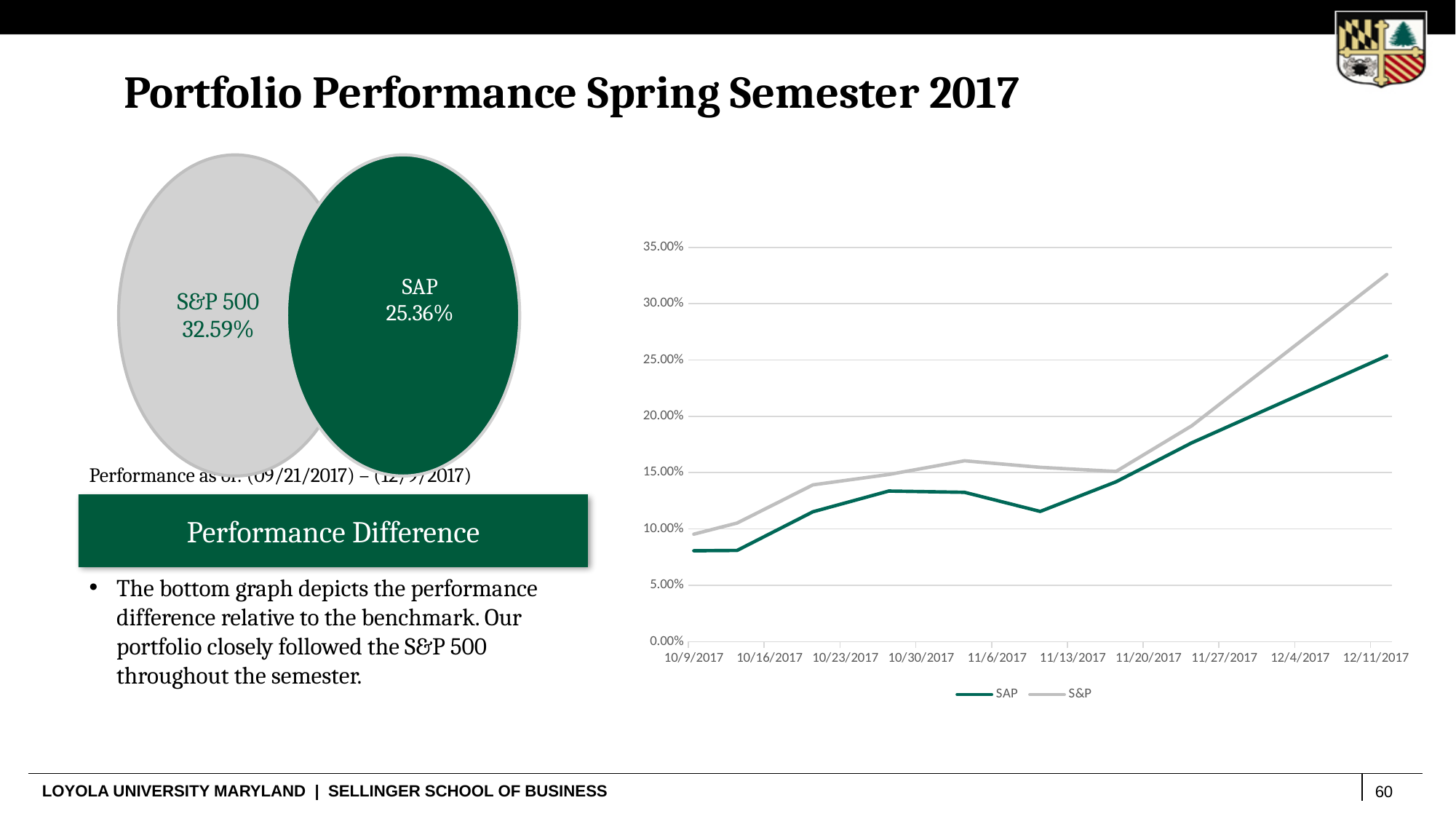
In the line chart, do the SAP and S&P values generally rise or fall from 10/9/2017 to 12/11/2017? rise In the line chart, is the S&P value on 12/11/2017 greater or less than 30.00%? greater In the line chart, is the SAP value on 11/13/2017 greater or less than 15.00%? less In the line chart, on which date does the S&P series reach its highest value? 12/11/2017 What are the two entries in the legend of the line chart? SAP and S&P In the line chart, is the SAP value on 12/11/2017 greater or less than 30.00%? less How many dates are shown along the x axis of the line chart? 10 How many series does the legend of the line chart list? 2 In the line chart, which series has the higher value on 12/11/2017, SAP or S&P? S&P What kind of chart is shown on the right side of the slide? line chart